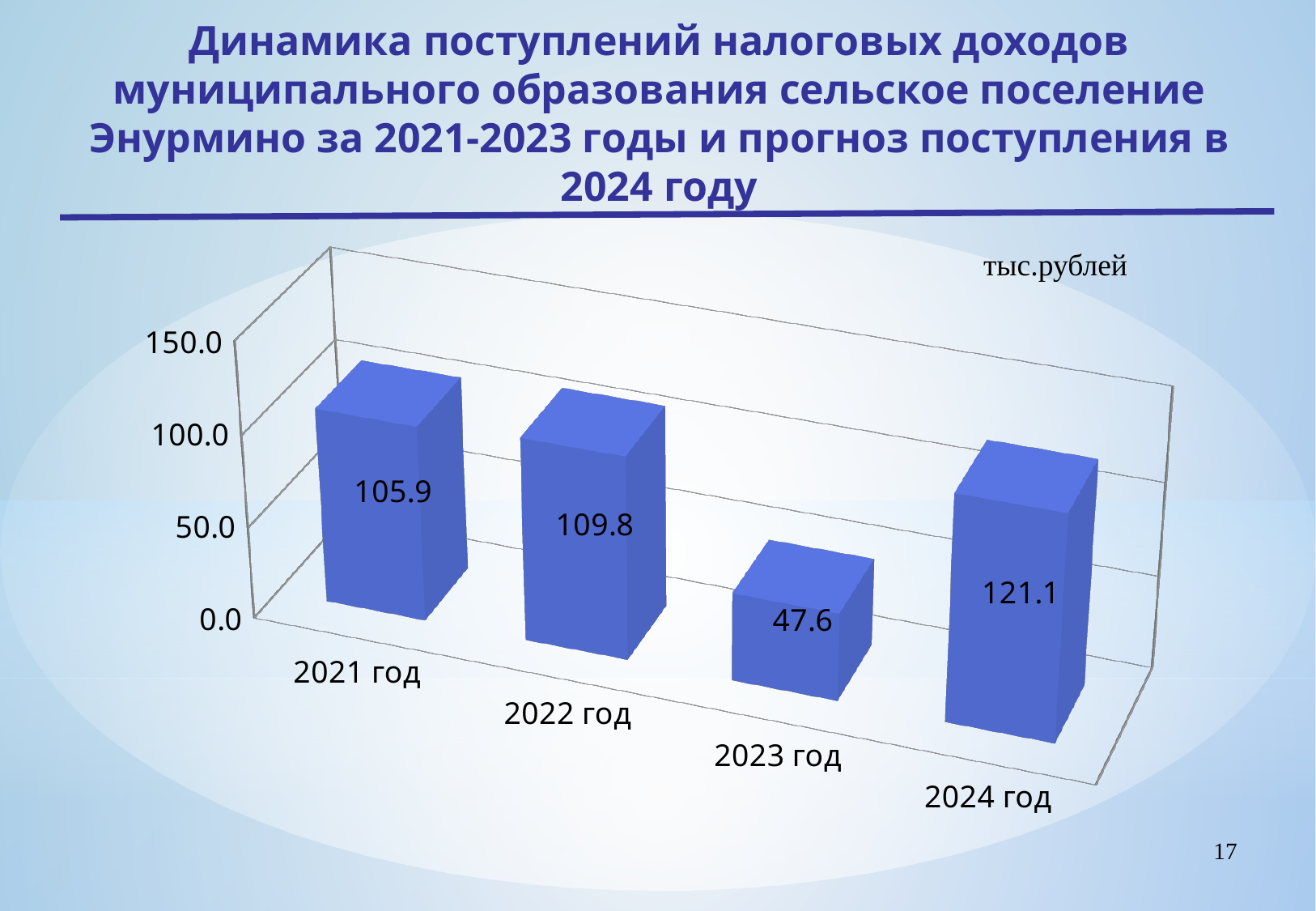
What is the forecast value for 2024 год? 121.1 How many years are shown on the chart? 4 Which year has the highest value? 2024 год What kind of chart is shown on the slide? bar chart What is the difference between the values for 2022 год and 2023 год? 62.2 What is the difference between the values for 2024 год and 2021 год? 15.2 Which year has the lowest value? 2023 год What is the value for 2021 год? 105.9 What is the value for 2023 год? 47.6 Is the value for 2023 год greater or less than 50.0? less Which is larger, the value for 2021 год or 2022 год? 2022 год What unit is indicated in the top right corner of the chart? тыс.рублей